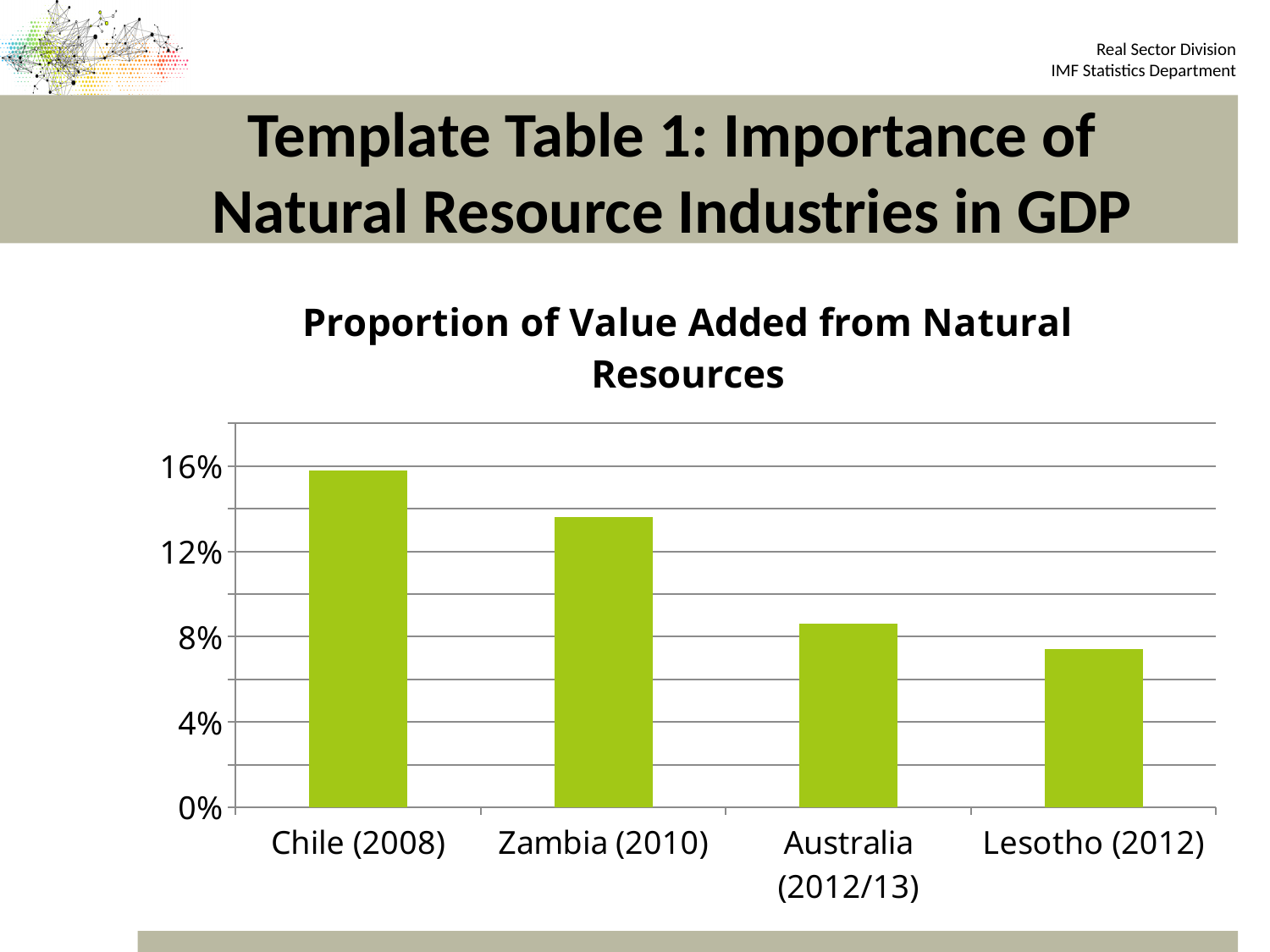
Is the value for Zambia (2010) greater or less than 16%? less Which country has the highest proportion of value added from natural resources? Chile (2008) Is the value for Lesotho (2012) greater or less than 8%? less What is the title of the chart? Proportion of Value Added from Natural Resources Is the value for Australia (2012/13) greater or less than 12%? less What kind of chart is shown on the slide? Bar chart Which is larger, the value for Australia (2012/13) or Lesotho (2012)? Australia (2012/13) How many countries are shown on the chart? 4 Do the values rise or fall moving from left to right across the chart? Fall Which country has the lowest proportion of value added from natural resources? Lesotho (2012) Which is larger, the value for Chile (2008) or Zambia (2010)? Chile (2008)